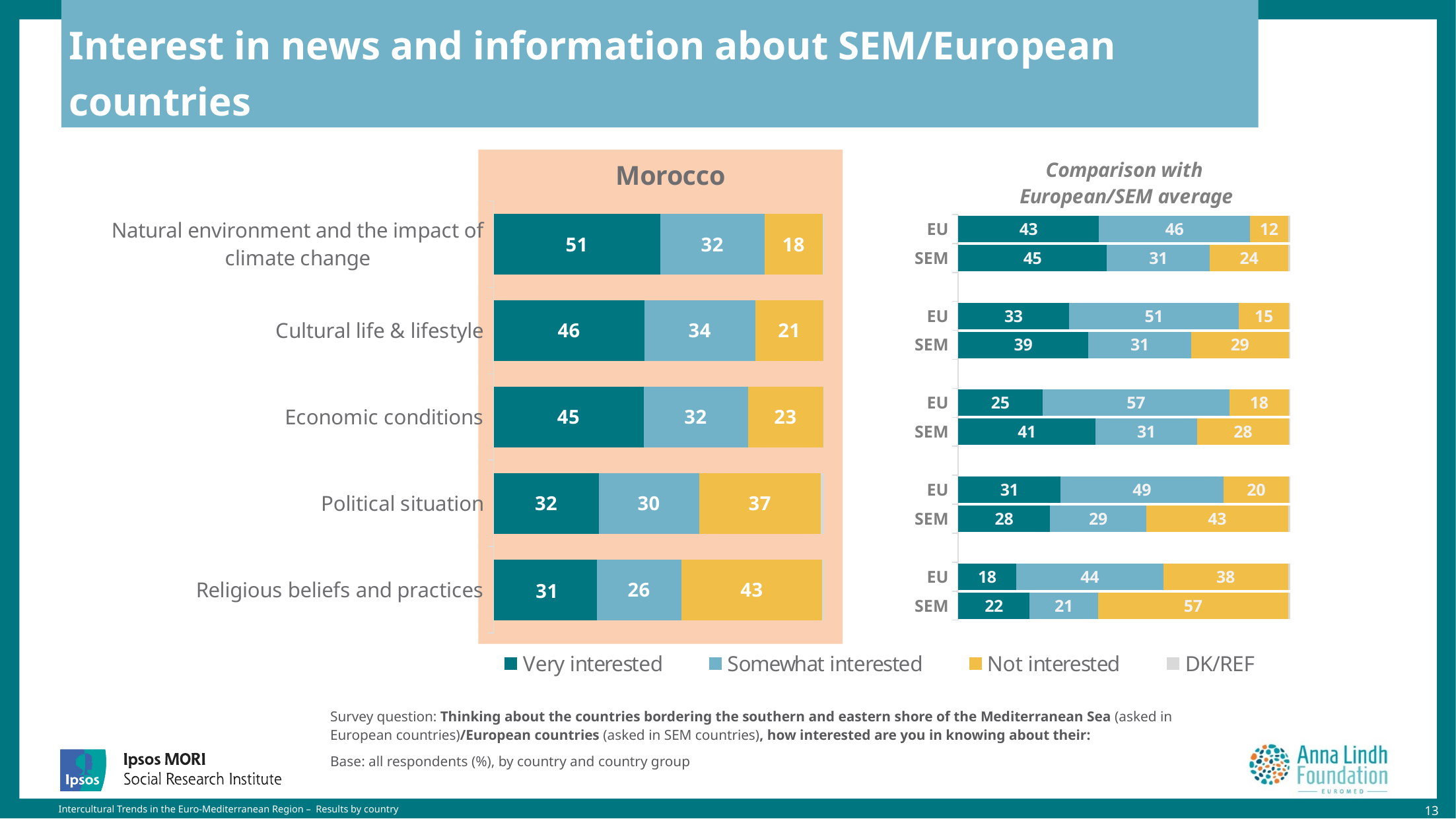
How many series does the legend list? 4 In the 'Comparison with European/SEM average' chart, what is the 'Not interested' value for SEM on religious beliefs and practices? 57 In the Morocco chart, is the 'Not interested' value larger for political situation or for economic conditions? Political situation In the 'Comparison with European/SEM average' chart, what is the total of the EU bar for the natural environment topic (43, 46 and 12)? 101 In the Morocco chart, what percentage is 'Very interested' in news about the natural environment and the impact of climate change? 51 What kind of chart is the Morocco chart? Stacked bar chart In the Morocco chart, which topic has the highest 'Very interested' value? Natural environment and the impact of climate change In the Morocco chart, which topic has the lowest 'Somewhat interested' value? Religious beliefs and practices In the Morocco chart, what is the difference between the 'Very interested' values for cultural life & lifestyle and political situation? 14 How many topics are shown in the Morocco chart? 5 In the 'Comparison with European/SEM average' chart, what is the 'Somewhat interested' value for the EU on economic conditions? 57 In the Morocco chart, what is the 'Not interested' value for religious beliefs and practices? 43